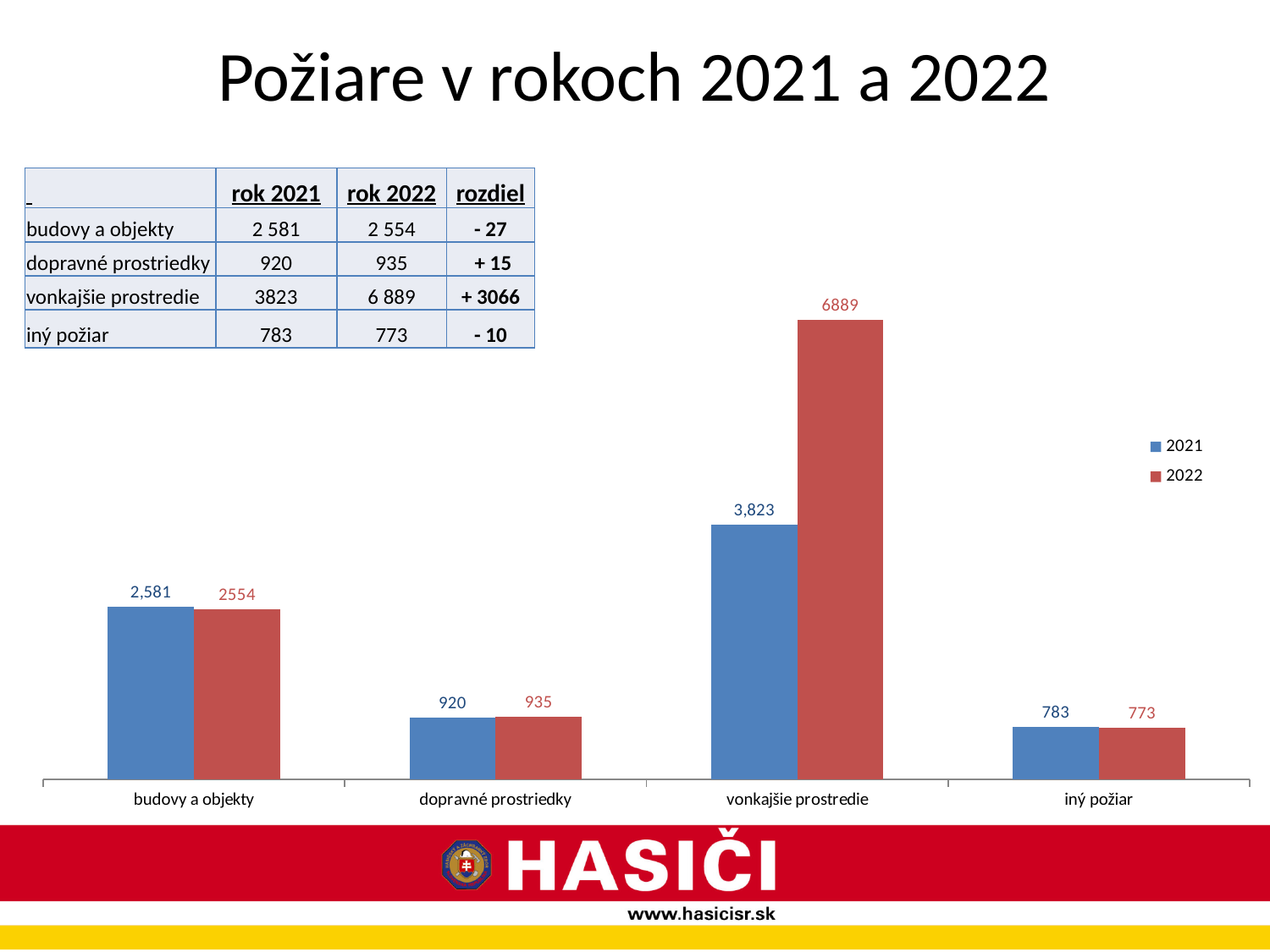
Which category has the highest 2022 value in the chart? vonkajšie prostredie What is the 2022 value for vonkajšie prostredie in the chart? 6889 Which category has the lowest 2021 value in the chart? iný požiar What is the 2021 value for budovy a objekty in the chart? 2,581 What is the 2022 value for iný požiar in the chart? 773 How many categories are shown on the x axis of the chart? 4 What is the difference between the 2022 and 2021 values for vonkajšie prostredie in the chart? 3066 What is the 2021 value for vonkajšie prostredie in the chart? 3,823 What is the 2022 value for dopravné prostriedky in the chart? 935 How many series does the chart legend list? 2 What type of chart is shown on the slide? bar chart Which is larger for dopravné prostriedky in the chart, the 2021 value or the 2022 value? 2022